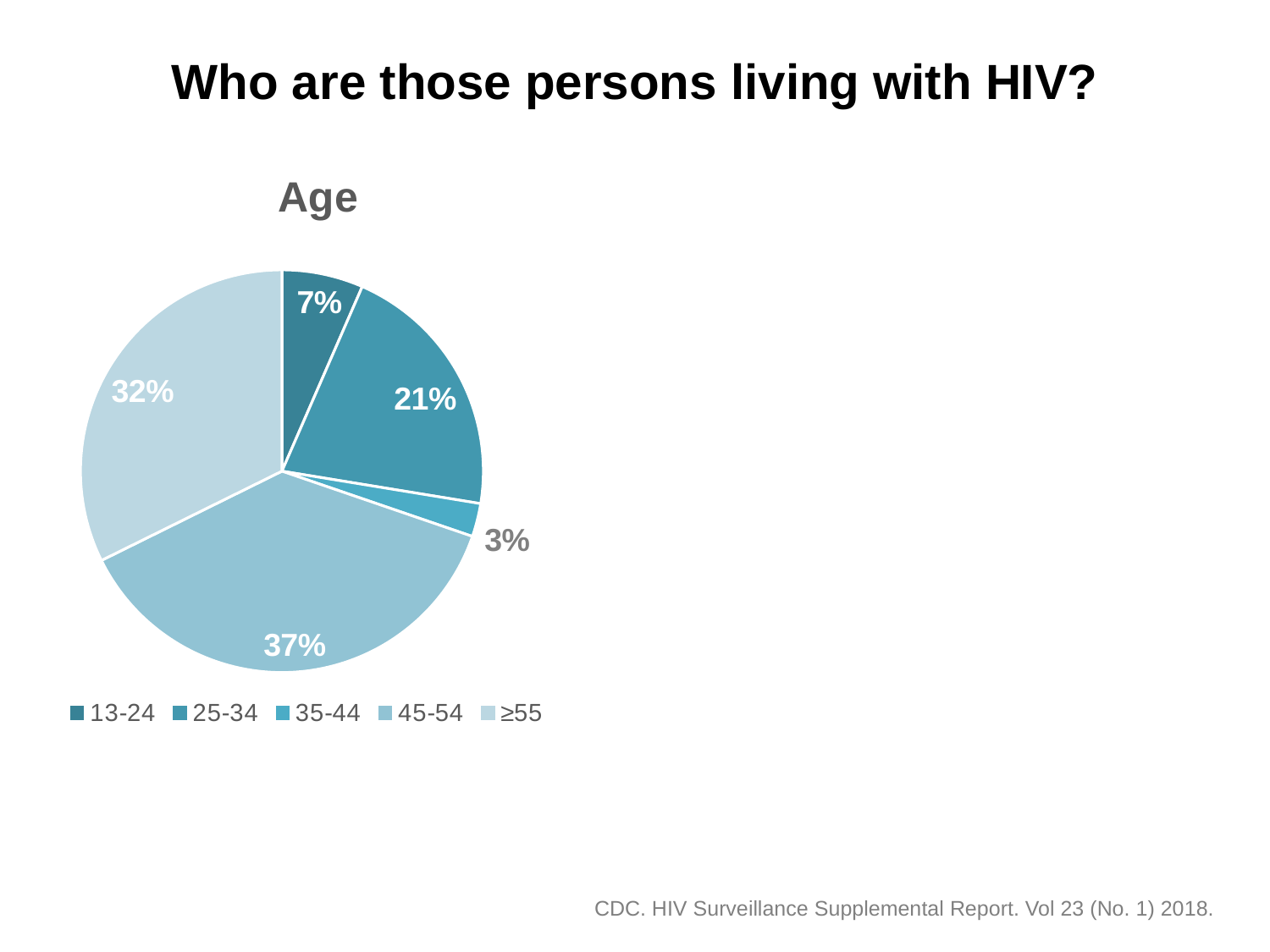
Which age group has the smallest share of the pie? 35-44 What kind of chart is shown on the slide? Pie chart What percentage of persons living with HIV are aged 13-24? 7% Which age group has the largest share of the pie? 45-54 What percentage of persons living with HIV are aged 55 or older? 32% What percentage of persons living with HIV are aged 45-54? 37% Which age group has a larger share, 25-34 or ≥55? ≥55 What percentage of persons living with HIV are aged 25-34? 21% What percentage of persons living with HIV are aged 35-44? 3% What is the difference in percentage points between the 45-54 and ≥55 age groups? 5 percentage points How many age groups are shown in the pie chart? 5 What is the title of the chart? Age